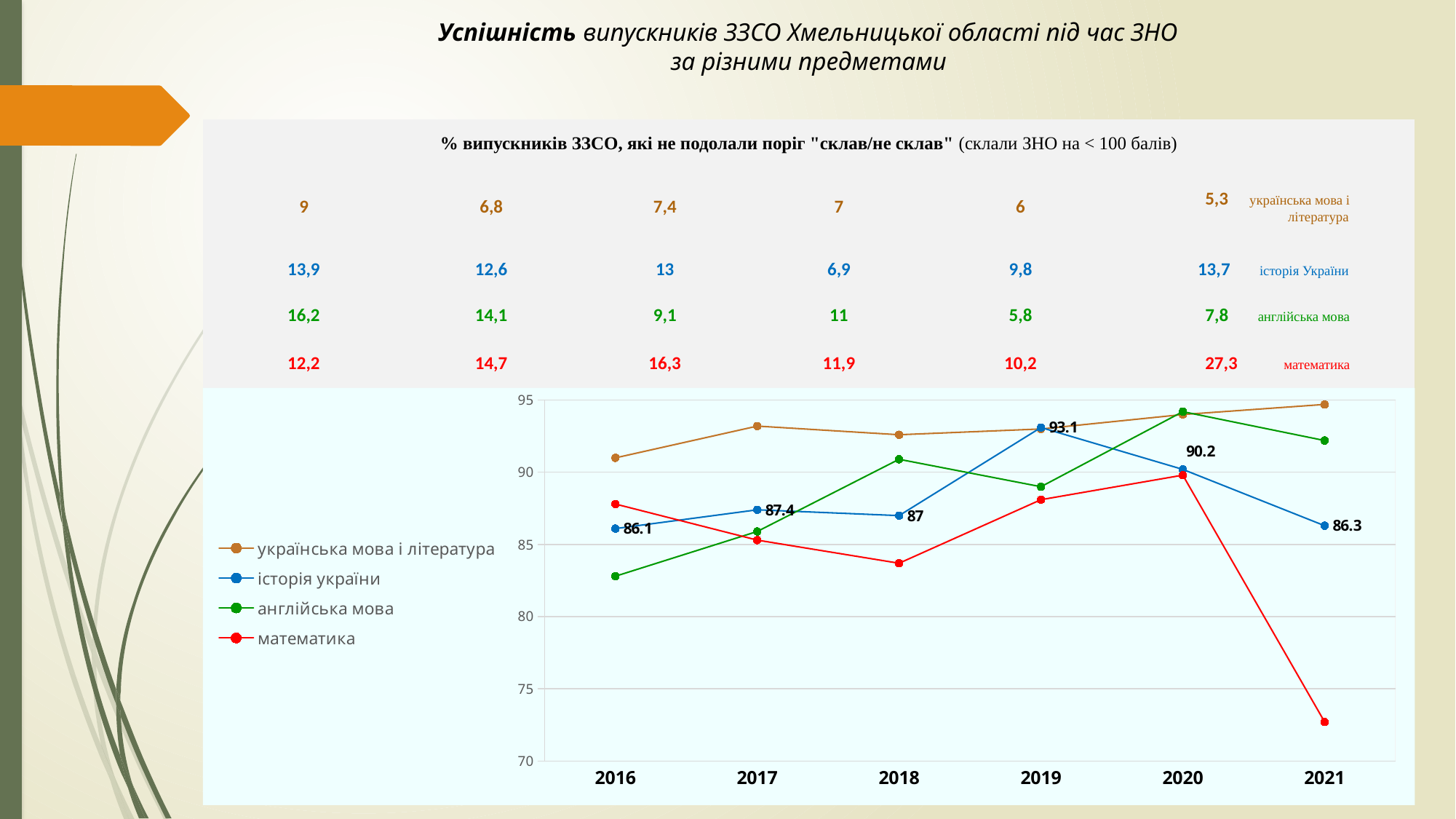
Does the value for математика rise or fall from 2020 to 2021? fall What kind of chart is shown on the slide? line chart By how much is the 2019 value for історія України higher than its 2016 value? 7 What is the value for історія України in 2016? 86.1 In which year does історія України reach its highest value? 2019 Is the value for математика in 2021 greater or less than 75? less How many series does the chart legend list? 4 How many years are plotted along the x axis of the chart? 6 What is the value for історія України in 2019? 93.1 What is the value for історія України in 2021? 86.3 What is the value for історія України in 2020? 90.2 Which series has the lowest value in 2021? математика